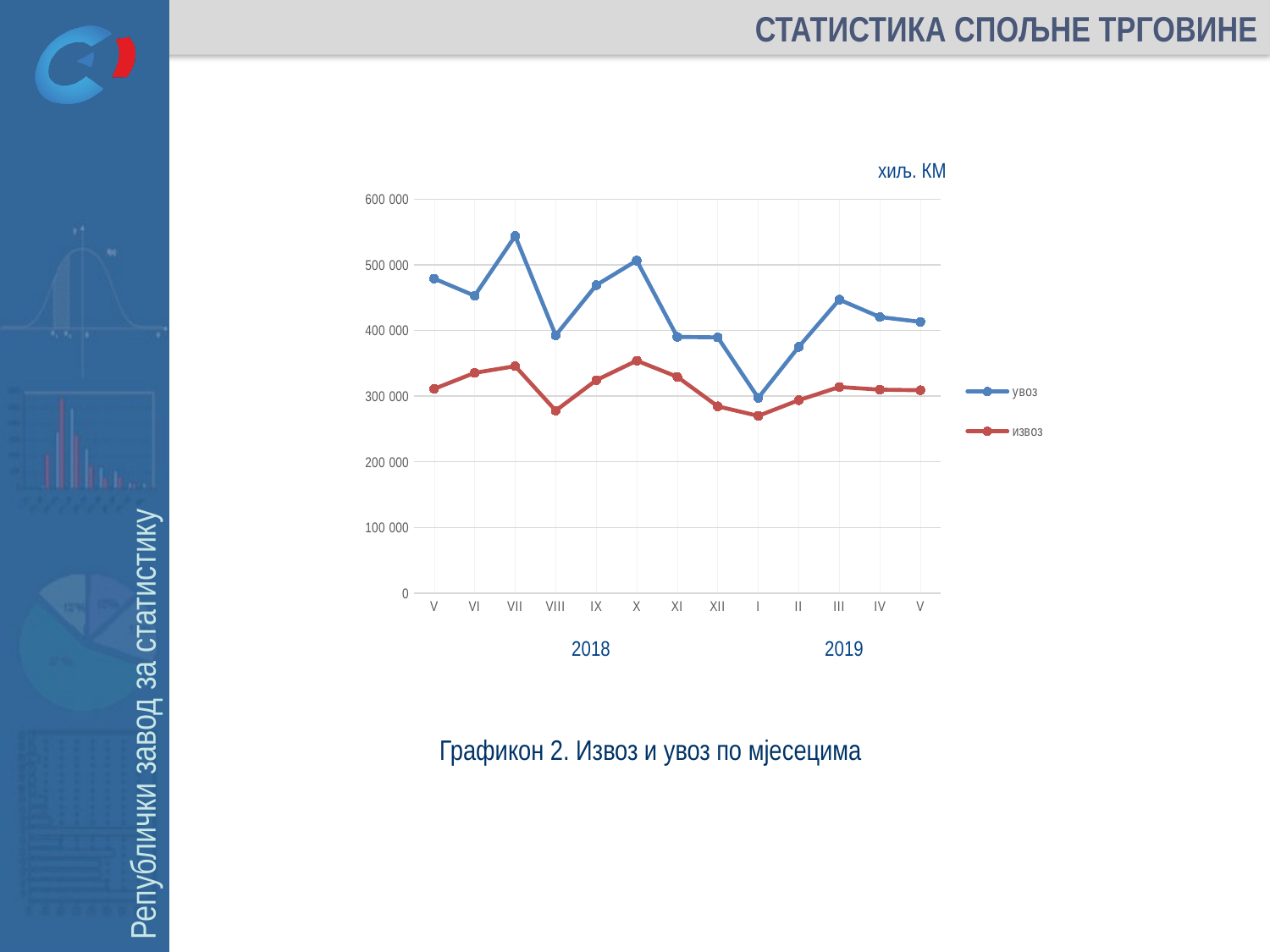
In which month is the value for увоз highest? VII 2018 How many series does the legend list? 2 What unit is indicated above the chart? хиљ. КМ How many months (data points) are plotted along the x axis? 13 Does the value for увоз rise or fall from VII 2018 to VIII 2018? fall Is the value for увоз in I 2019 greater or less than 400 000? less Is the value for увоз in VII 2018 greater or less than 500 000? greater What kind of chart is shown on the slide? line chart In which month is the value for увоз lowest? I 2019 Is the value for извоз in X 2018 greater or less than 300 000? greater Which is larger in X 2018, увоз or извоз? увоз